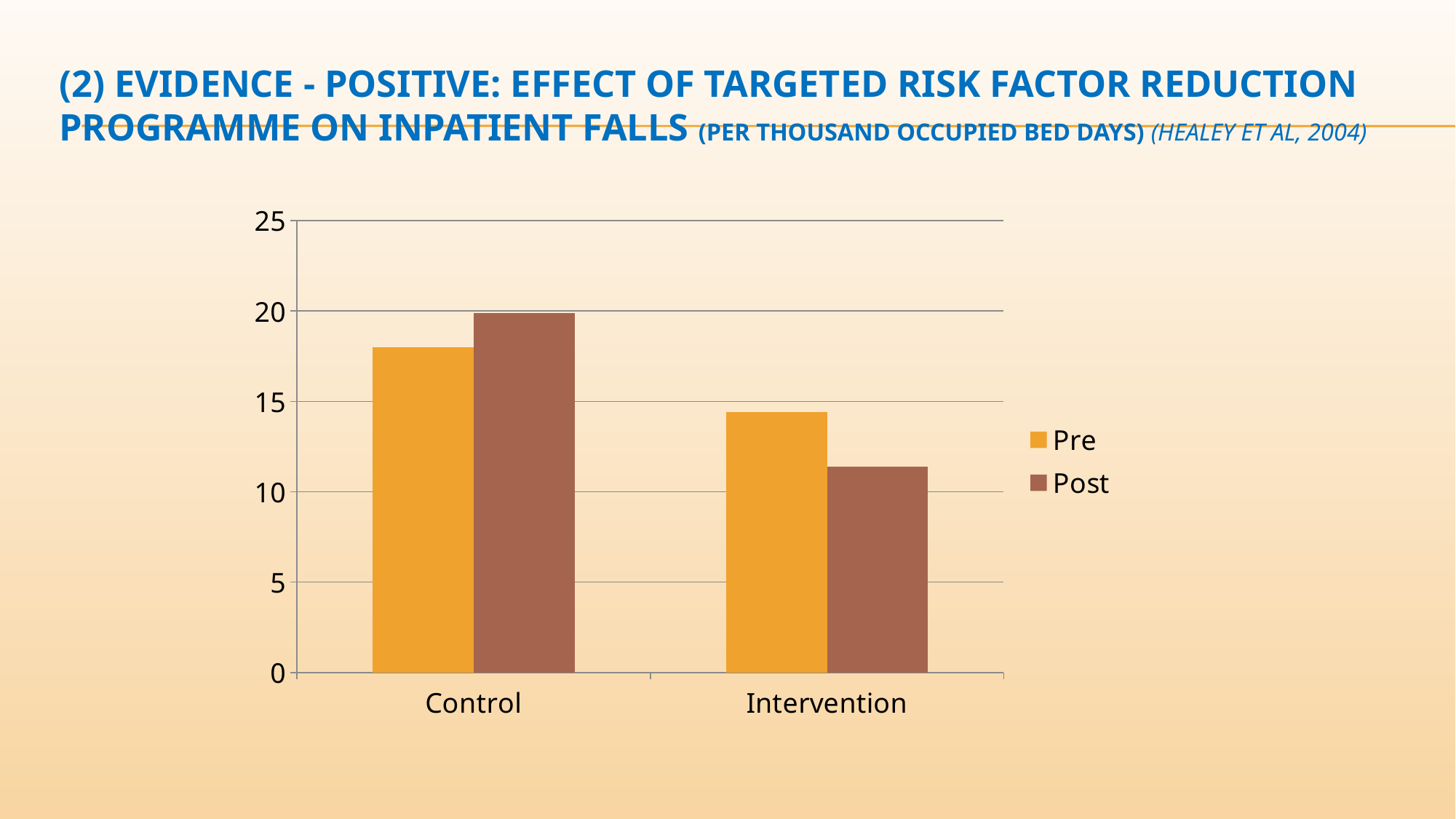
How many series does the legend list? 2 For the Control group, which is larger, the Pre value or the Post value? Post How many categories are shown on the x axis of the chart? 2 Which bar is the tallest in the chart? Control, Post For the Intervention group, which is larger, the Pre value or the Post value? Pre Which series is shown in brown in the chart? Post Is the Post value for Intervention greater or less than 10? greater Is the Post value for Intervention greater or less than 15? less Which bar is the shortest in the chart? Intervention, Post Is the Pre value for Control greater or less than 15? greater What are the two legend entries of the chart? Pre and Post What kind of chart is shown on the slide? Bar chart